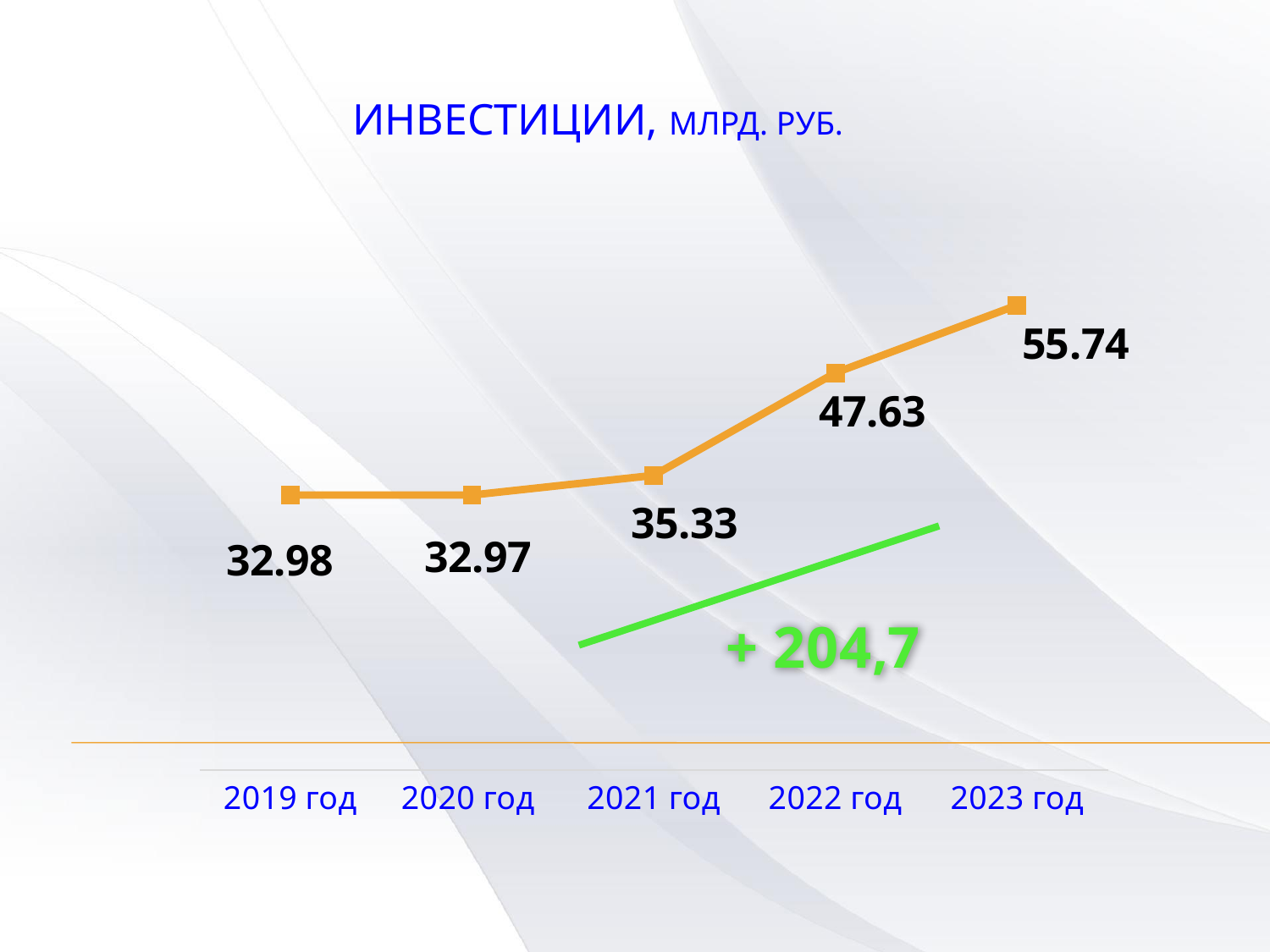
What is the title of the chart? ИНВЕСТИЦИИ, МЛРД. РУБ. Which year has the lowest investment value? 2020 год What is the investment value for 2021 год? 35.33 Which is larger, the investment value for 2022 год or for 2021 год? 2022 год What is the investment value for 2023 год? 55.74 What is the investment value for 2019 год? 32.98 What is the difference between the investment values for 2023 год and 2019 год? 22.76 Which year has the highest investment value? 2023 год How many years are plotted on the chart? 5 What is the difference between the investment values for 2022 год and 2021 год? 12.30 Do the investment values rise or fall from 2019 год to 2023 год? rise What kind of chart is shown on the slide? line chart